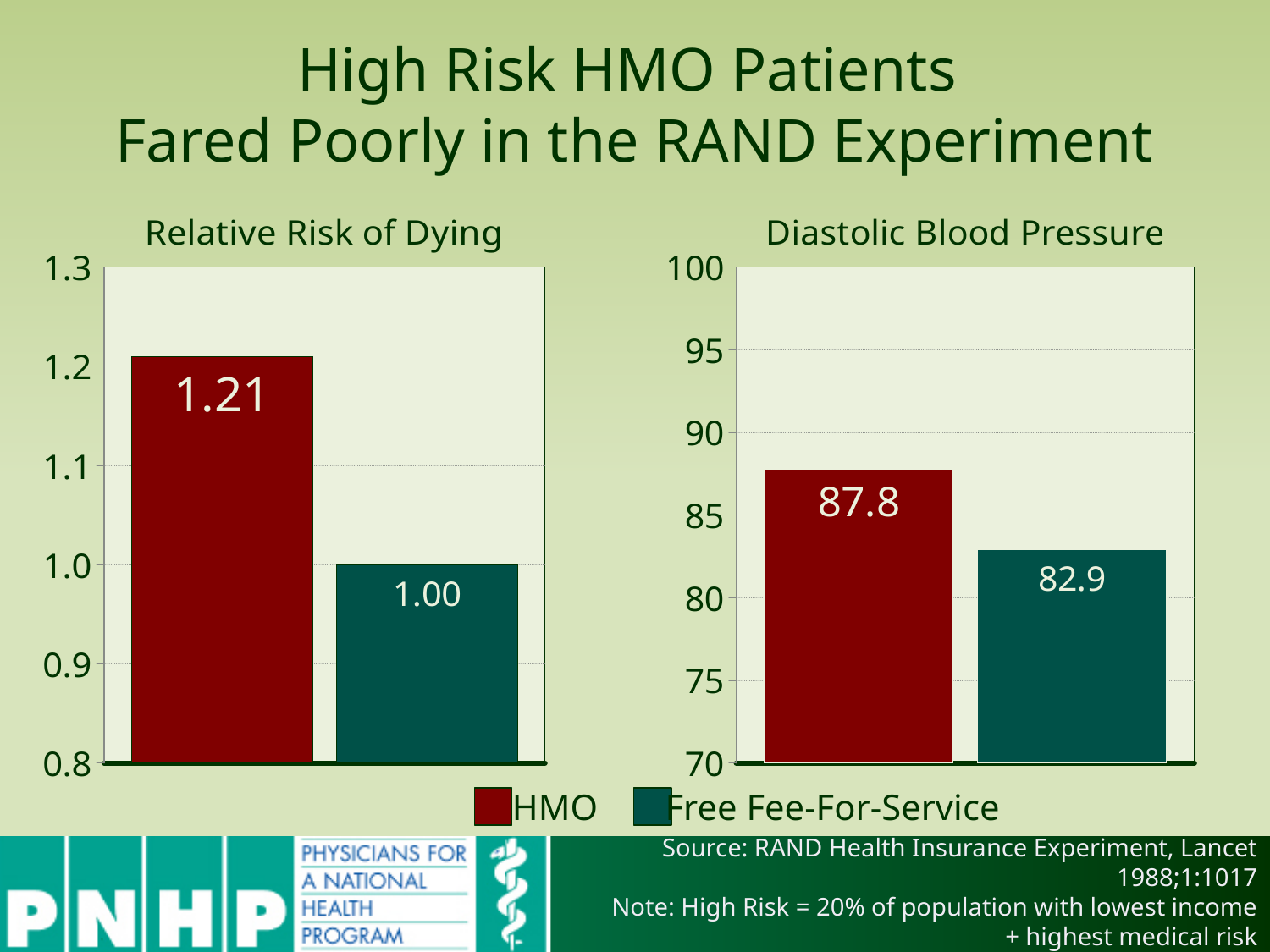
In the Relative Risk of Dying chart, what is the difference between the HMO and Free Fee-For-Service values? 0.21 In the Diastolic Blood Pressure chart, is the Free Fee-For-Service value greater or less than 85? less In the Relative Risk of Dying chart, what is the value for HMO? 1.21 In the Relative Risk of Dying chart, is the HMO value greater or less than 1.2? greater In the Relative Risk of Dying chart, what is the value for Free Fee-For-Service? 1.00 In the Diastolic Blood Pressure chart, what is the value for Free Fee-For-Service? 82.9 In the Relative Risk of Dying chart, which group has the lower value? Free Fee-For-Service In the Diastolic Blood Pressure chart, what is the difference between the HMO and Free Fee-For-Service values? 4.9 How many series does the legend list? 2 What type of chart is the Diastolic Blood Pressure chart? Bar chart In the Diastolic Blood Pressure chart, which group has the higher value? HMO In the Diastolic Blood Pressure chart, what is the value for HMO? 87.8